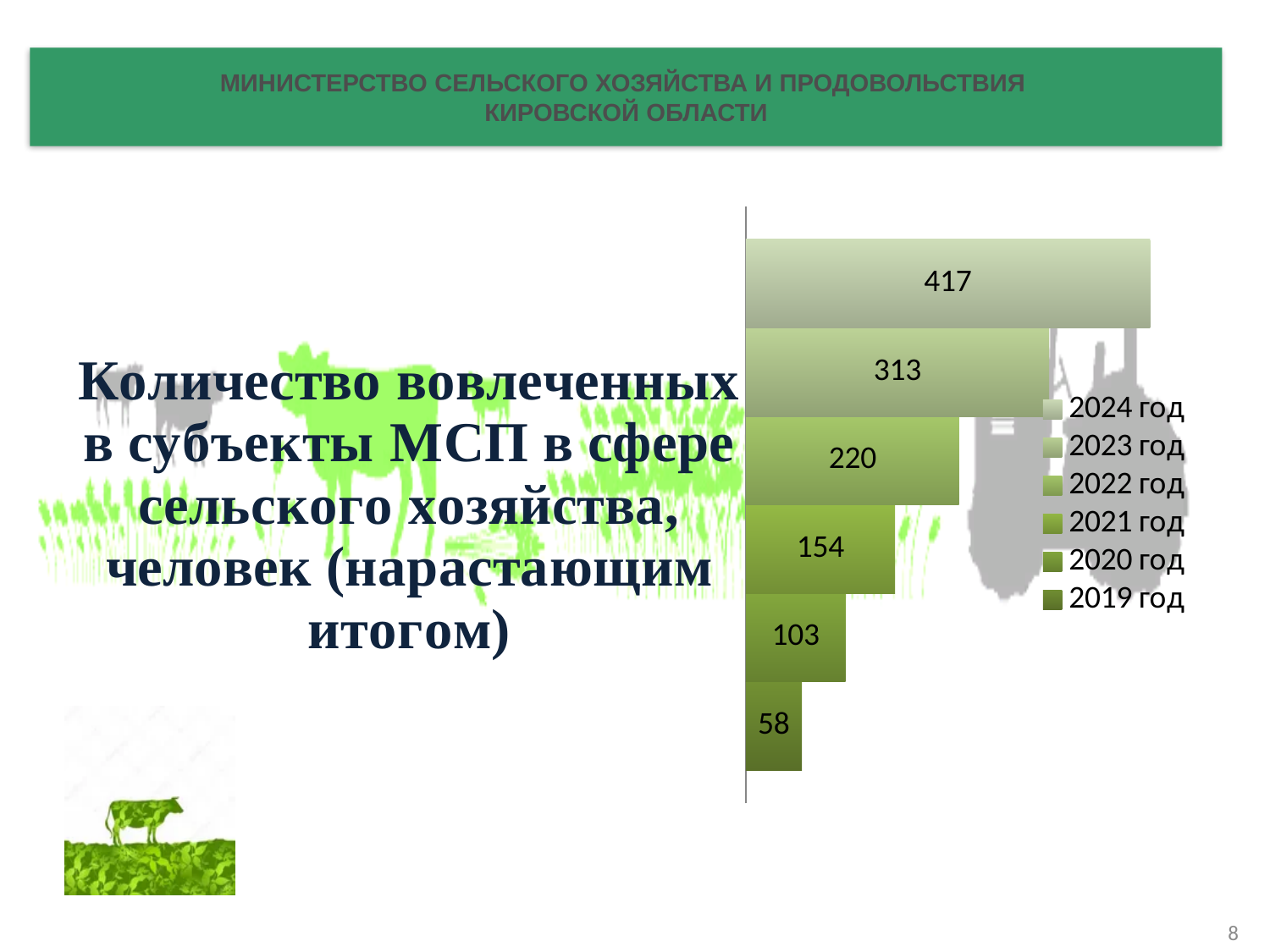
What is the value for 2021 год? 154 What kind of chart is shown on the slide? Bar chart How many entries does the legend list? 6 How many bars are shown in the chart? 6 Which is larger, the value for 2023 год or the value for 2022 год? 2023 год What is the value for 2019 год? 58 What is the difference between the values for 2024 год and 2023 год? 104 What is the value for 2024 год? 417 Which year has the highest value? 2024 год What is the difference between the values for 2020 год and 2019 год? 45 Which year has the lowest value? 2019 год What is the value for 2022 год? 220